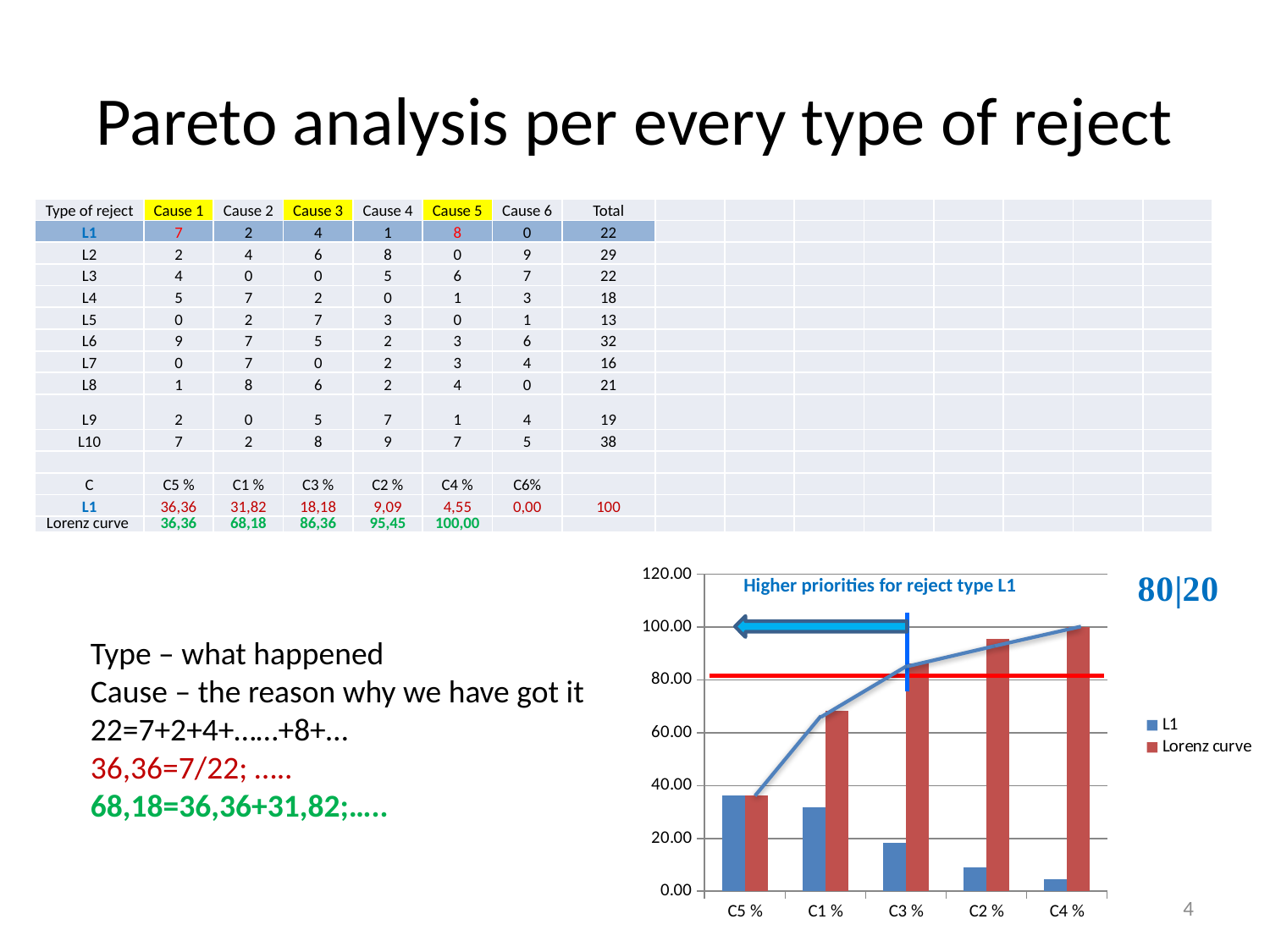
Which category has the highest Lorenz curve value in the chart? C4 % Do the L1 values rise or fall from C5 % to C4 % along the x axis? fall Which category has the highest L1 value in the chart? C5 % How many series does the chart legend list? 2 How many categories are shown on the x axis of the chart? 5 What text is written as the title inside the chart? Higher priorities for reject type L1 Is the Lorenz curve value for C3 % greater or less than 80.00? greater Which is larger in the chart: the L1 value for C5 % or the L1 value for C1 %? C5 % What type of chart is shown on the slide? bar chart Which category has the lowest L1 value in the chart? C4 % Is the L1 value for C2 % greater or less than 20.00? less Do the Lorenz curve values rise or fall from C5 % to C4 % along the x axis? rise